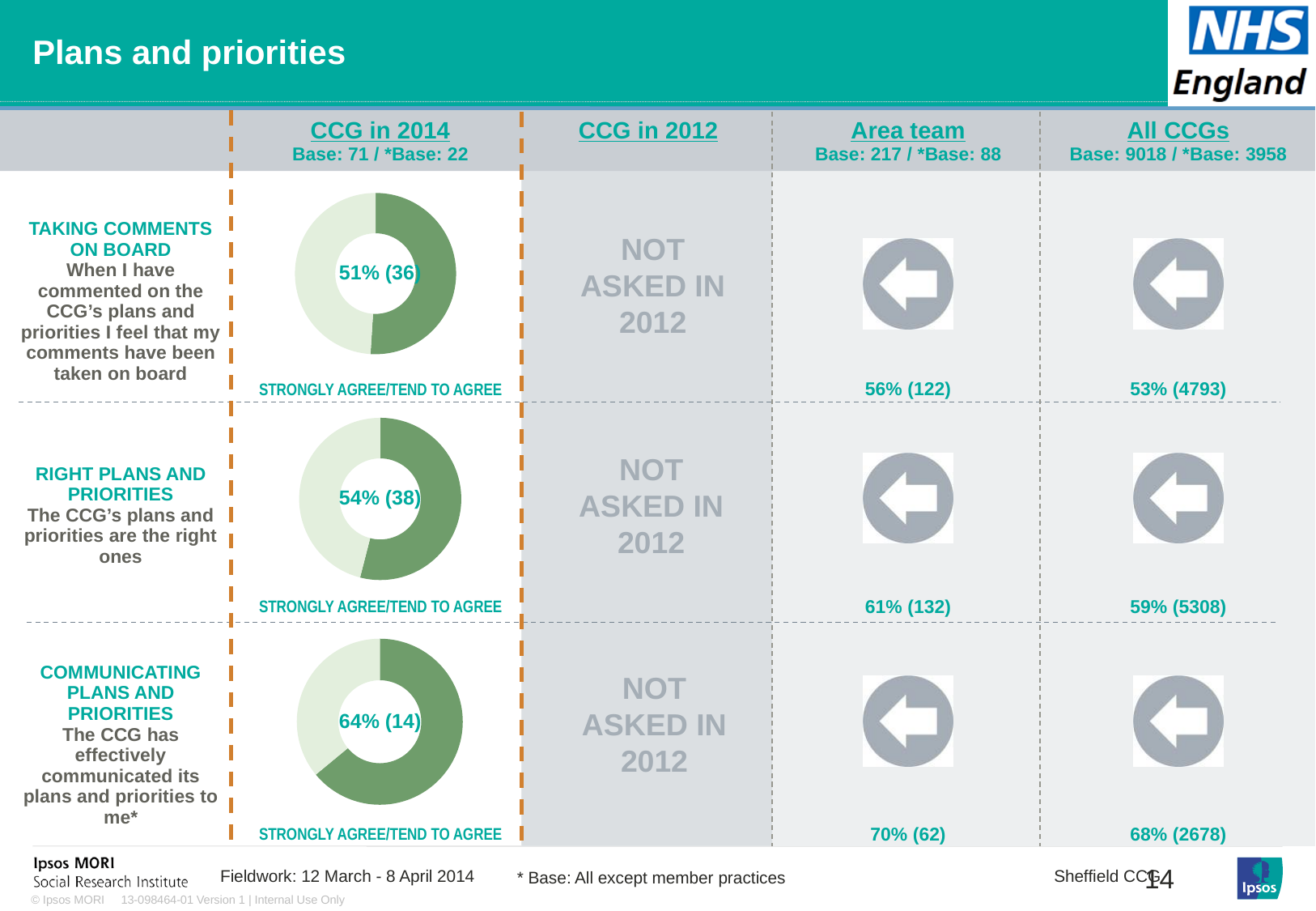
Which is larger: the agreement percentage in the 'Right plans and priorities' donut or in the 'Taking comments on board' donut? Right plans and priorities What is shown in the 'CCG in 2012' column instead of a chart for each statement? NOT ASKED IN 2012 What is the difference in percentage points between the 'Communicating plans and priorities' donut (64%) and the 'Taking comments on board' donut (51%)? 13 percentage points Which of the three CCG in 2014 donut charts shows the highest percentage agreeing? Communicating plans and priorities What type of chart is used in the 'CCG in 2014' column? Pie chart (donut) In the 'Communicating plans and priorities' donut chart for CCG in 2014, what percentage strongly agree or tend to agree? 64% How many donut charts are shown on the slide? 3 What label appears beneath each donut chart in the 'CCG in 2014' column? STRONGLY AGREE/TEND TO AGREE In the 'Taking comments on board' donut chart for CCG in 2014, what percentage strongly agree or tend to agree? 51% Which of the three CCG in 2014 donut charts shows the lowest percentage agreeing? Taking comments on board In the 'Communicating plans and priorities' donut chart, how many respondents does the 64% represent, as shown in brackets? 14 In the 'Right plans and priorities' donut chart for CCG in 2014, what percentage strongly agree or tend to agree? 54%